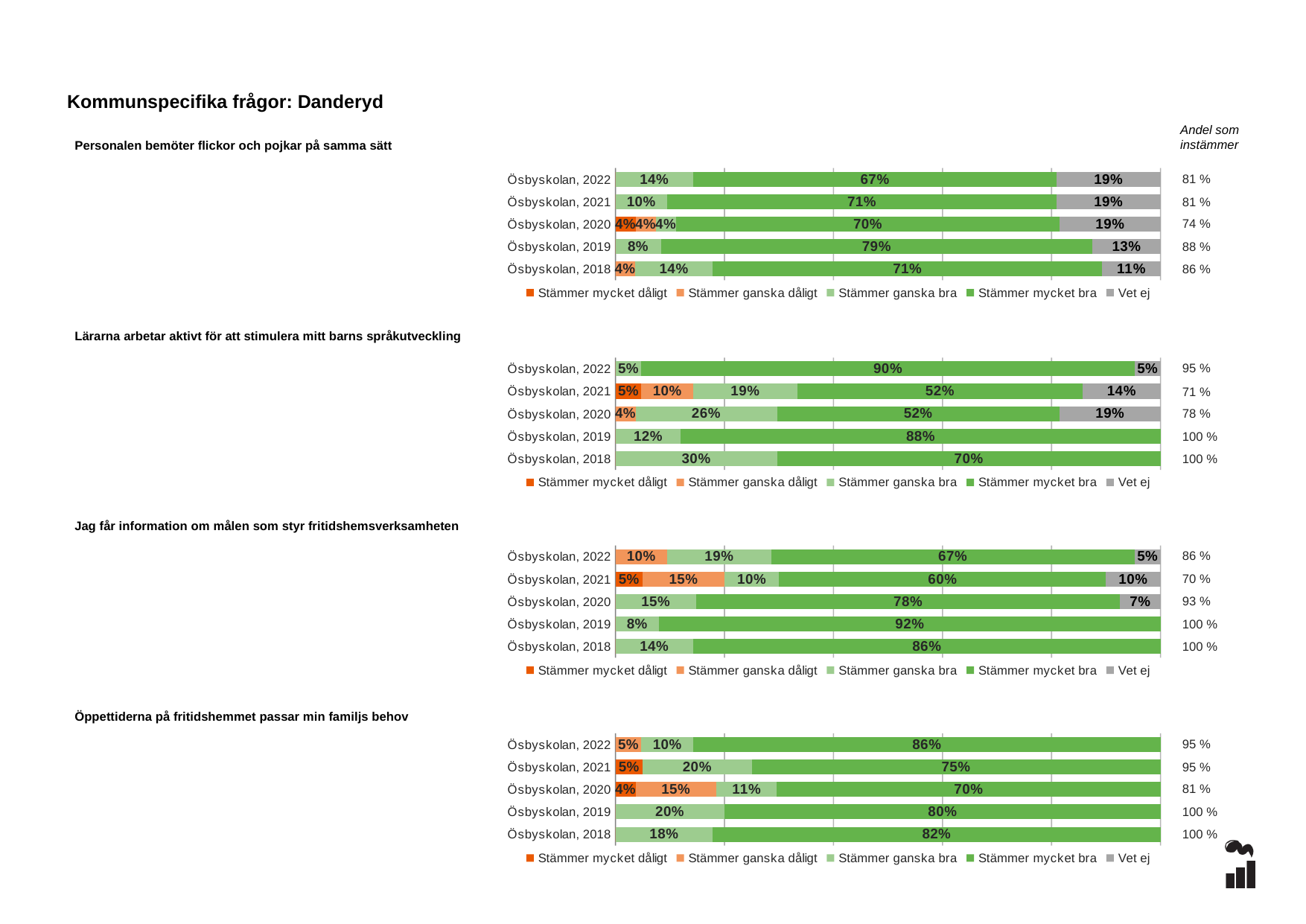
In the chart 'Jag får information om målen som styr fritidshemsverksamheten', what is the 'Stämmer ganska dåligt' value for Ösbyskolan, 2021? 15% What kind of chart is used for 'Personalen bemöter flickor och pojkar på samma sätt'? Stacked bar chart In the chart 'Öppettiderna på fritidshemmet passar min familjs behov', how many years (bars) are shown? 5 In the chart 'Personalen bemöter flickor och pojkar på samma sätt', what is the 'Stämmer mycket bra' value for Ösbyskolan, 2019? 79% In the chart 'Lärarna arbetar aktivt för att stimulera mitt barns språkutveckling', which year has the lowest 'Stämmer mycket bra' value? Ösbyskolan, 2021 and Ösbyskolan, 2020 (both 52%) How many series does the legend list in the chart 'Öppettiderna på fritidshemmet passar min familjs behov'? 5 In the chart 'Personalen bemöter flickor och pojkar på samma sätt', which year has the highest 'Stämmer mycket bra' value? Ösbyskolan, 2019 In the chart 'Lärarna arbetar aktivt för att stimulera mitt barns språkutveckling', what is the 'Stämmer mycket bra' value for Ösbyskolan, 2022? 90% In the chart 'Öppettiderna på fritidshemmet passar min familjs behov', what is the 'Stämmer ganska bra' value for Ösbyskolan, 2019? 20% In the chart 'Jag får information om målen som styr fritidshemsverksamheten', which is larger: the 'Stämmer mycket bra' value for Ösbyskolan, 2020 or for Ösbyskolan, 2022? Ösbyskolan, 2020 In the chart 'Lärarna arbetar aktivt för att stimulera mitt barns språkutveckling', what is the difference between the 'Stämmer mycket bra' values for Ösbyskolan, 2019 and Ösbyskolan, 2021? 36% In the chart 'Personalen bemöter flickor och pojkar på samma sätt', what is the 'Vet ej' value for Ösbyskolan, 2018? 11%